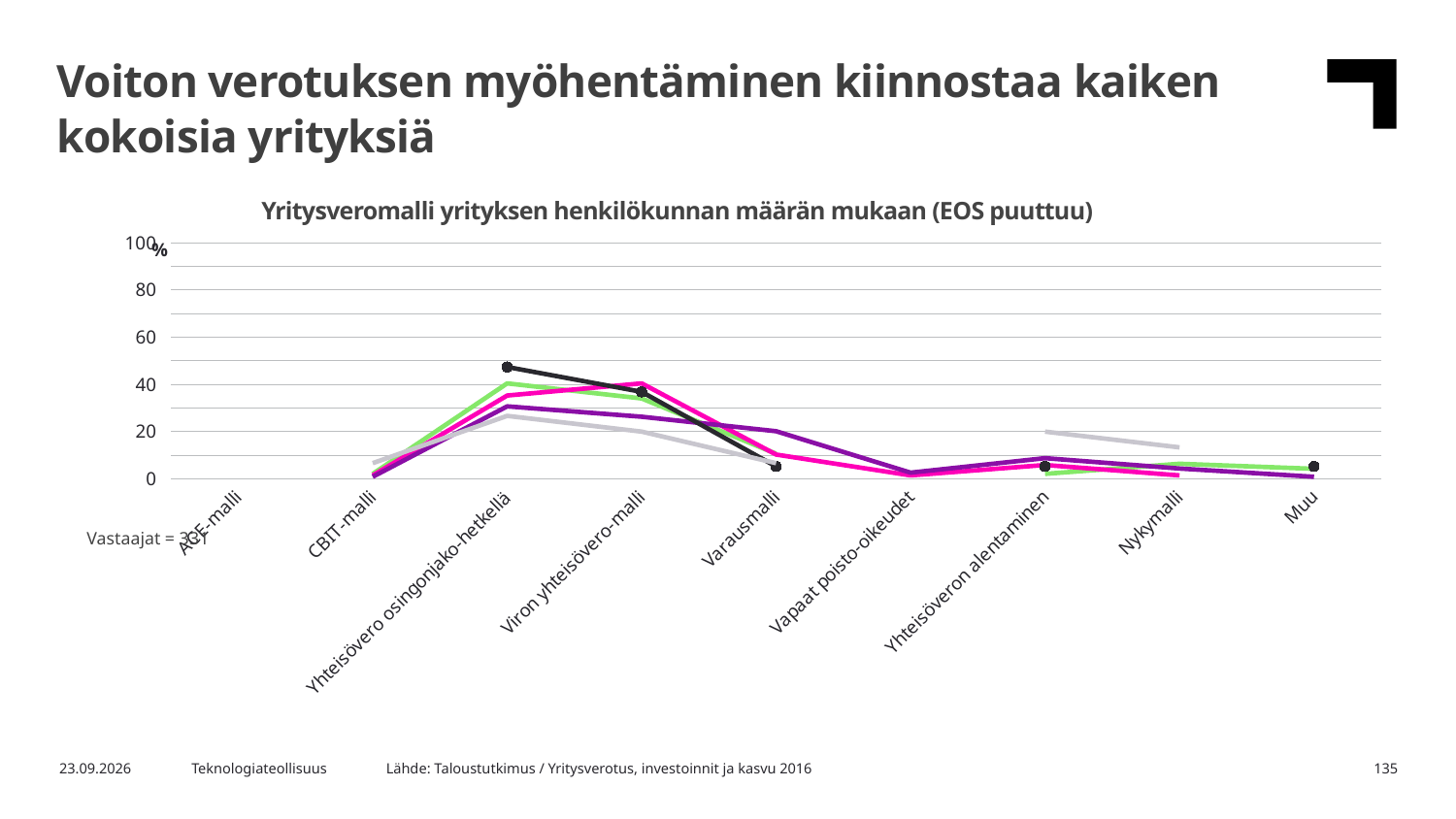
Is the highest plotted value at Yhteisövero osingonjako-hetkellä greater or less than 40? greater What kind of chart is shown on the slide? line chart Is the highest plotted value at Viron yhteisövero-malli greater or less than 20? greater Is the highest plotted value at Vapaat poisto-oikeudet greater or less than 20? less Do the lines rise or fall between Viron yhteisövero-malli and Varausmalli? fall At which category does the chart reach its highest plotted value? Yhteisövero osingonjako-hetkellä How many categories are shown on the x axis of the chart? 9 What is the maximum value shown on the y axis of the chart? 100 Do the lines rise or fall between CBIT-malli and Yhteisövero osingonjako-hetkellä? rise What is the title of the chart? Yritysveromalli yrityksen henkilökunnan määrän mukaan (EOS puuttuu)